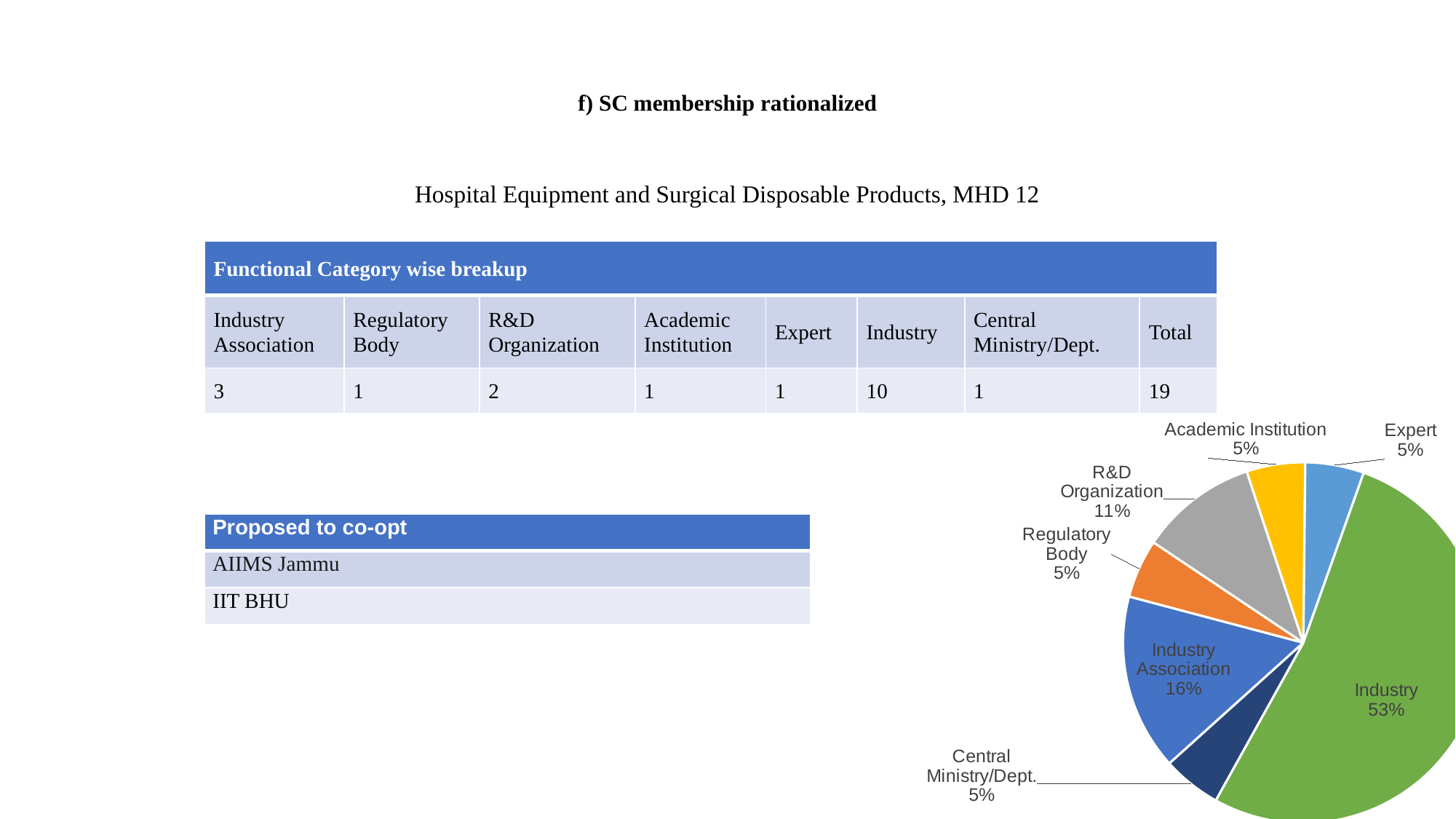
How many slices does the pie chart have? 7 What colour is the Industry slice in the pie chart? green What percentage is shown for Central Ministry/Dept. in the pie chart? 5% What share of the pie does R&D Organization account for? 11% What kind of chart is shown on the slide? pie chart What percentage is shown for Regulatory Body in the pie chart? 5% Which is larger in the pie chart, R&D Organization or Academic Institution? R&D Organization Is the share for Industry greater or less than 50%? greater What share of the pie does Industry Association account for? 16% What share of the pie does Industry account for? 53% Which category has the largest slice of the pie? Industry What is the difference in percentage points between Industry and Industry Association? 37